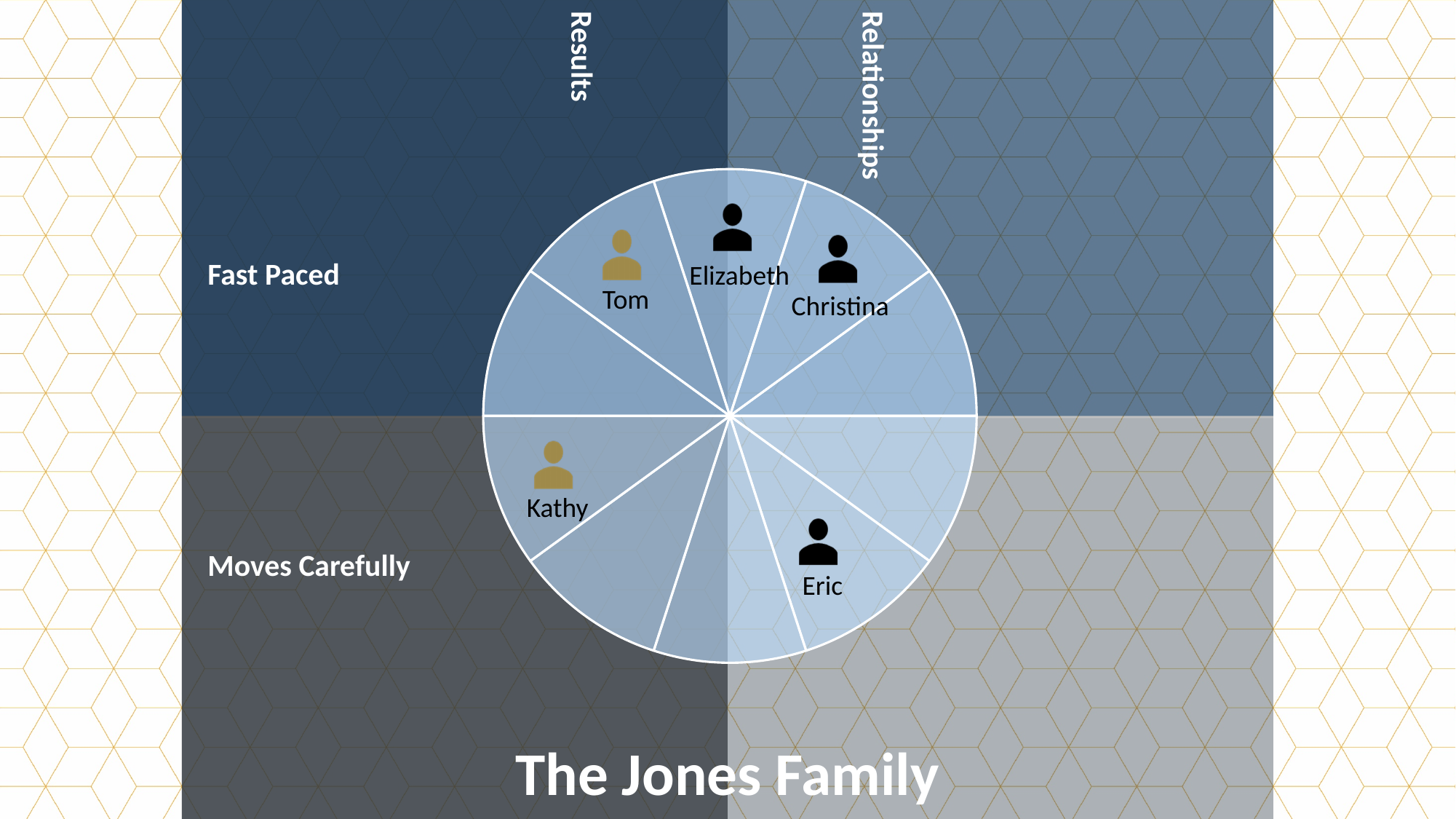
Which quadrant of the chart is Christina placed in? Relationships / Fast Paced Which two people are shown with gold-coloured icons? Tom and Kathy Which person is placed in the Results / Moves Carefully quadrant? Kathy How many named people are placed on the chart? 5 What is the title shown at the bottom of the slide? The Jones Family How many people are placed in the Fast Paced half of the chart? 3 How many people are placed in the Moves Carefully half of the chart? 2 Which quadrant of the chart is Tom placed in? Results / Fast Paced What kind of chart is shown on the slide? Pie chart Which quadrant of the chart is Eric placed in? Relationships / Moves Carefully